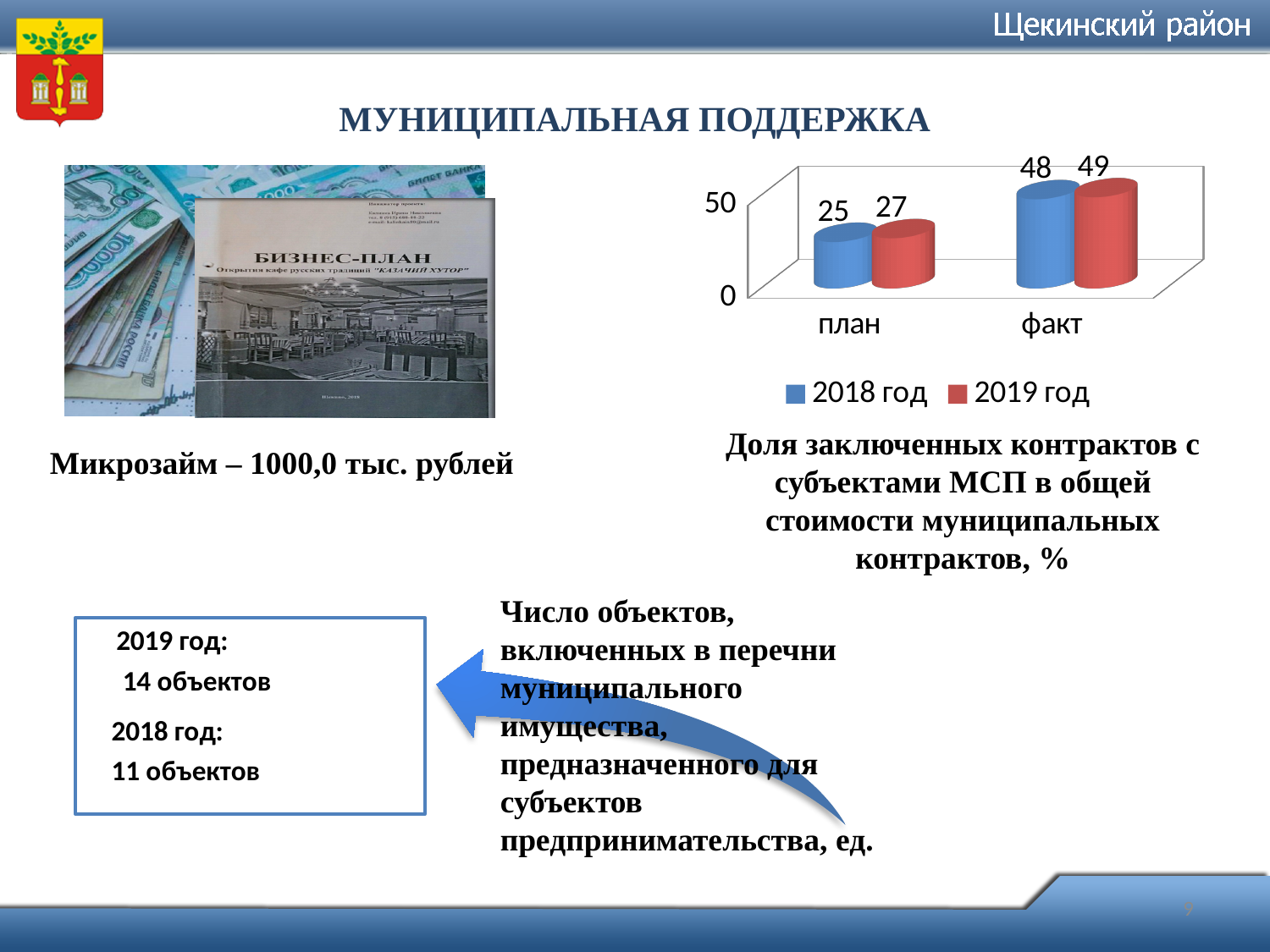
Which colour represents the 2019 год series in the chart? red How many categories are shown on the x axis of the chart? 2 What is the difference between the факт and план values for 2018 год? 23 Which category has the lowest value for the 2018 год series? план What is the value for 2018 год in the факт category? 48 Which category has the highest value for the 2019 год series? факт How many series does the chart legend list? 2 Which is larger: the план value for 2019 год or the факт value for 2018 год? факт value for 2018 год What is the value for 2019 год in the факт category? 49 What kind of chart is shown on the slide? bar chart What is the value for 2019 год in the план category? 27 What is the value for 2018 год in the план category? 25